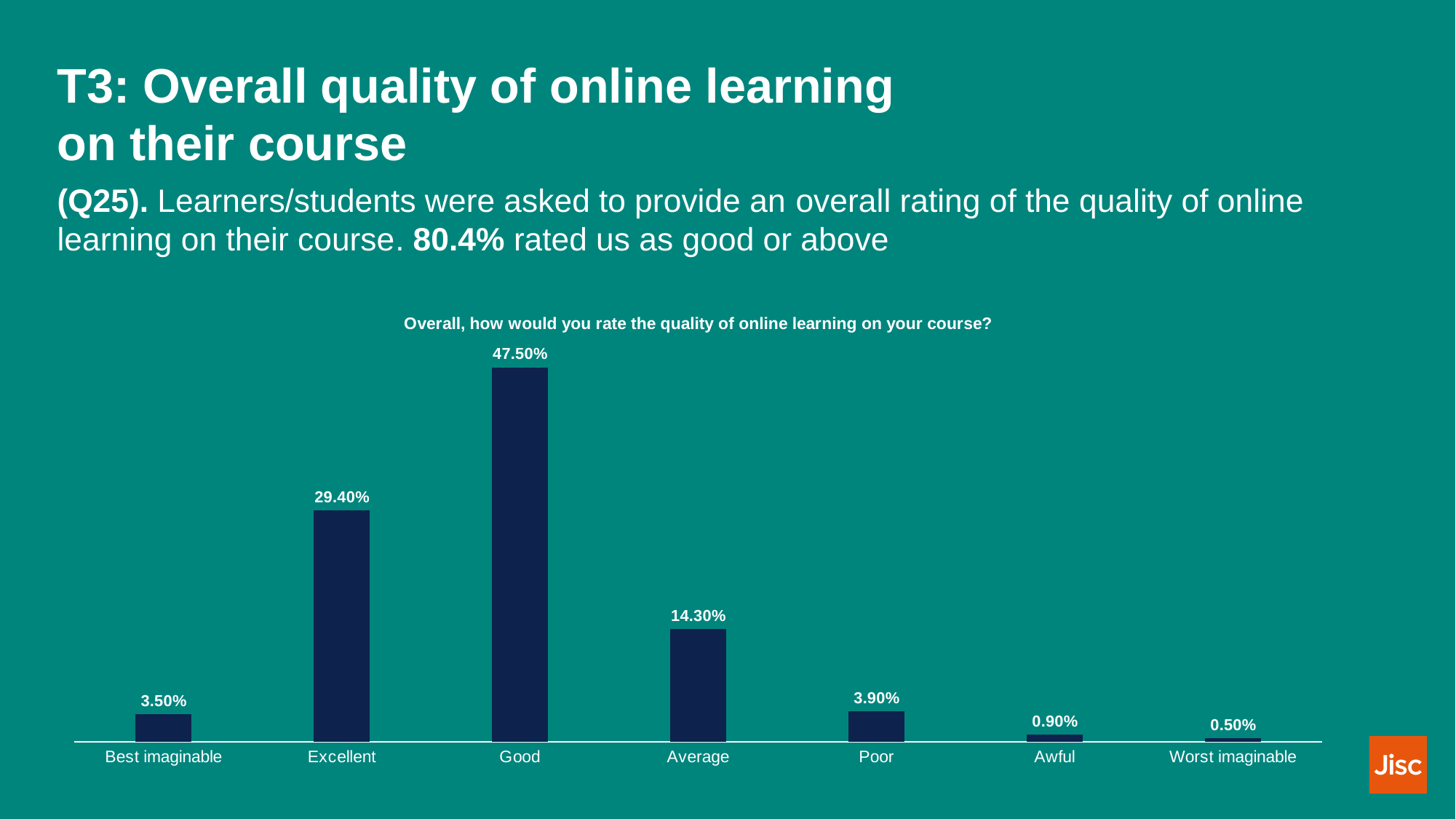
What is the difference between the values for Good and Excellent? 18.10% What percentage of respondents rated the quality of online learning on their course as Good? 47.50% What kind of chart is shown on the slide? Bar chart How many rating categories are shown on the x axis? 7 What is the title of the chart? Overall, how would you rate the quality of online learning on your course? What is the value shown for Excellent? 29.40% Which rating category has the lowest value? Worst imaginable Which is larger, the value for Best imaginable or the value for Poor? Poor Which rating category has the highest value? Good What is the combined value of Poor, Awful and Worst imaginable? 5.30% What percentage rated the quality as Average? 14.30% What is the value for Worst imaginable? 0.50%